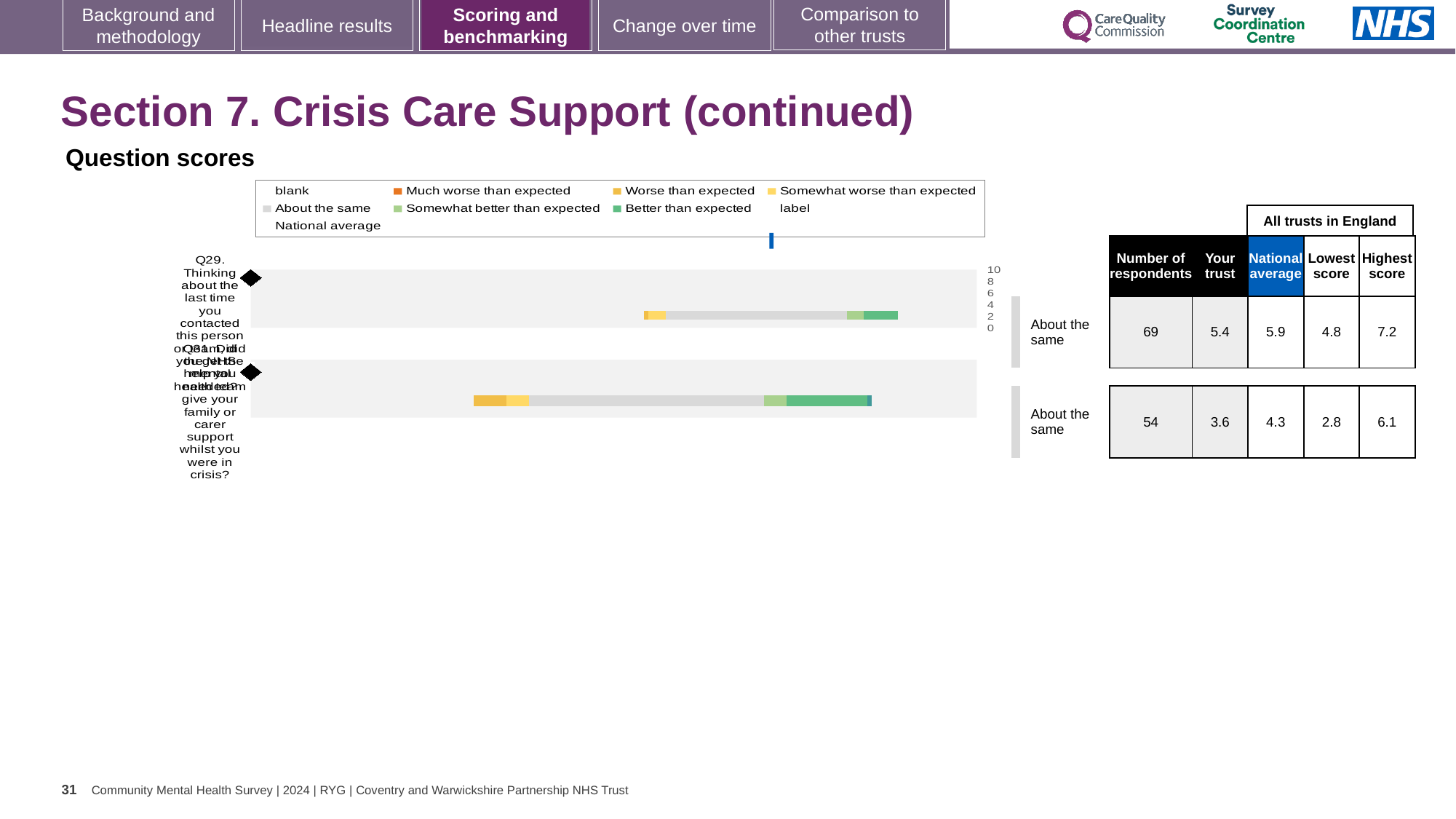
What is the difference between the highest and lowest scores for Q31? 3.3 What is the highest score across all trusts in England for Q31? 6.1 What colour represents 'Much worse than expected' in the legend? orange How many entries does the chart legend list? 9 How many questions (bars) are plotted in the chart? 2 What is the difference between the national average and the 'Your trust' score for Q29? 0.5 What colour represents 'Better than expected' in the legend? green What kind of chart is shown under 'Question scores'? bar chart What benchmark category is shown for Q29? About the same Which question has the higher 'Your trust' score, Q29 or Q31? Q29 What is the 'Your trust' score for Q31 in the table beside the chart? 3.6 How many respondents are listed for Q29 in the table beside the chart? 69